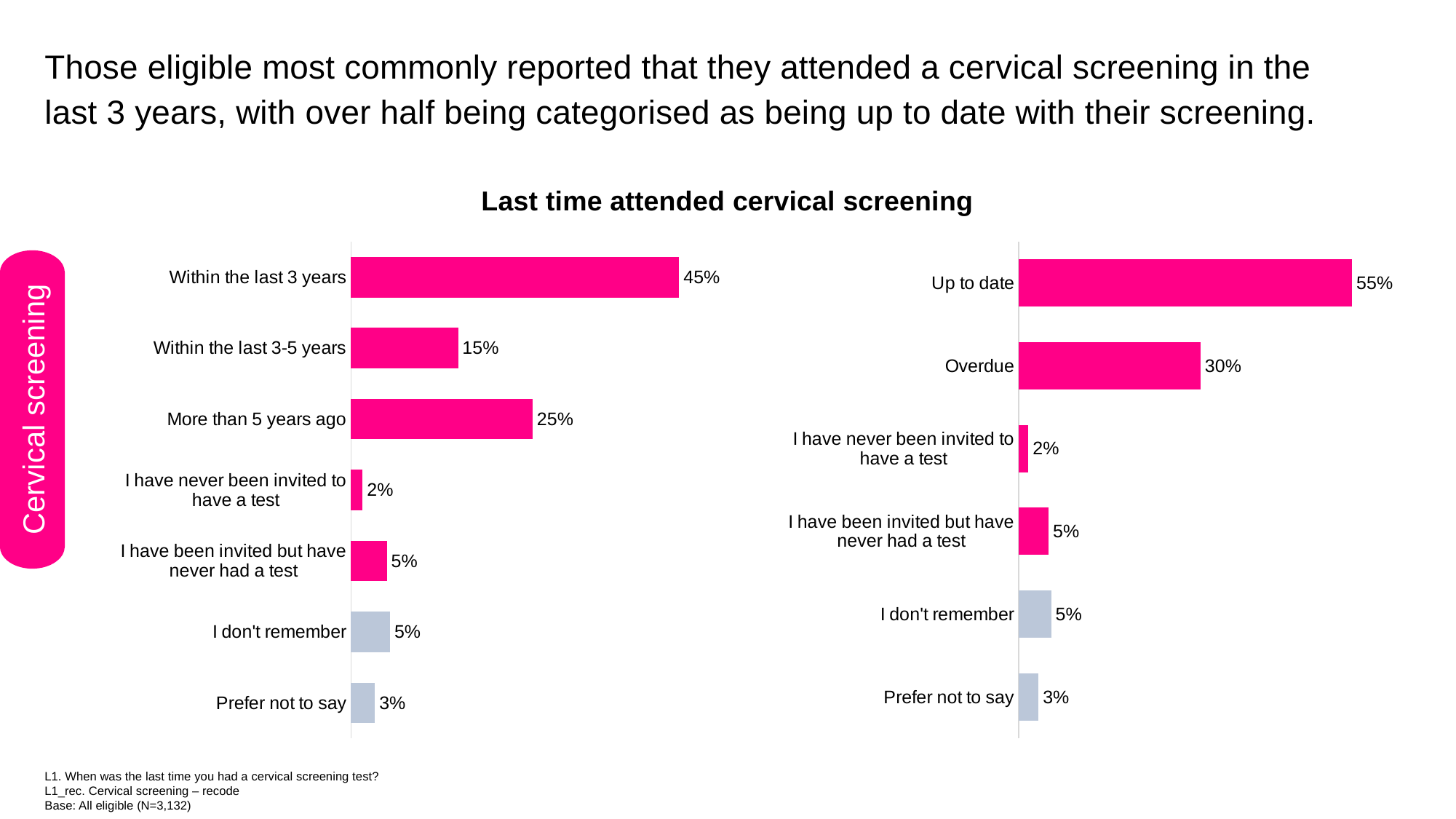
In the right chart, what percentage are categorised as Overdue? 30% In the right chart, which category has the highest value? Up to date In the left chart, what percentage reported attending a cervical screening within the last 3 years? 45% How many categories are shown in the left chart? 7 In the right chart, what is the difference between 'Up to date' and 'Overdue'? 25 percentage points In the left chart, what is the difference between 'Within the last 3 years' and 'Within the last 3-5 years'? 30 percentage points In the left chart, which is larger: 'More than 5 years ago' or 'Within the last 3-5 years'? More than 5 years ago What type of chart is used on this slide? Bar chart In the left chart, what is the value for 'More than 5 years ago'? 25% In the left chart, which category has the lowest value? I have never been invited to have a test What is the title shown above the charts? Last time attended cervical screening How many categories are shown in the right chart? 6